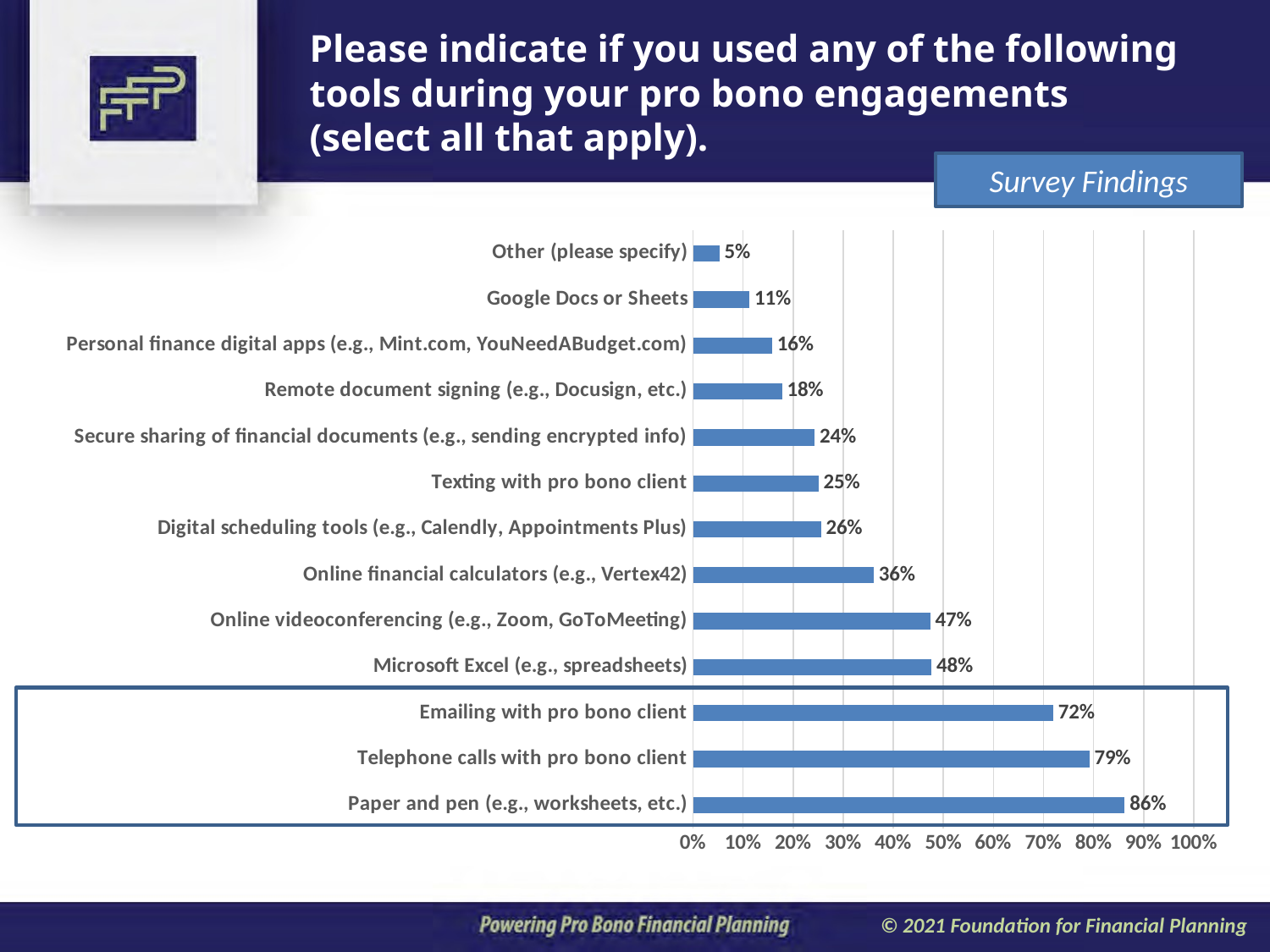
Which tool has the highest percentage of use? Paper and pen (e.g., worksheets, etc.) Which was used by more respondents: Microsoft Excel (e.g., spreadsheets) or online financial calculators (e.g., Vertex42)? Microsoft Excel (e.g., spreadsheets) What percentage of respondents used paper and pen (e.g., worksheets, etc.)? 86% What kind of chart is shown on the slide? Bar chart What is the difference in percentage points between telephone calls with pro bono client and emailing with pro bono client? 7 What percentage of respondents used online videoconferencing (e.g., Zoom, GoToMeeting)? 47% Which category has the lowest percentage? Other (please specify) What is the highest value shown on the horizontal axis? 100% What is the difference in percentage points between texting with pro bono client and secure sharing of financial documents (e.g., sending encrypted info)? 1 What percentage of respondents used Google Docs or Sheets? 11% Is the value for remote document signing (e.g., Docusign, etc.) greater or less than 20%? less How many tool categories are shown in the chart? 13